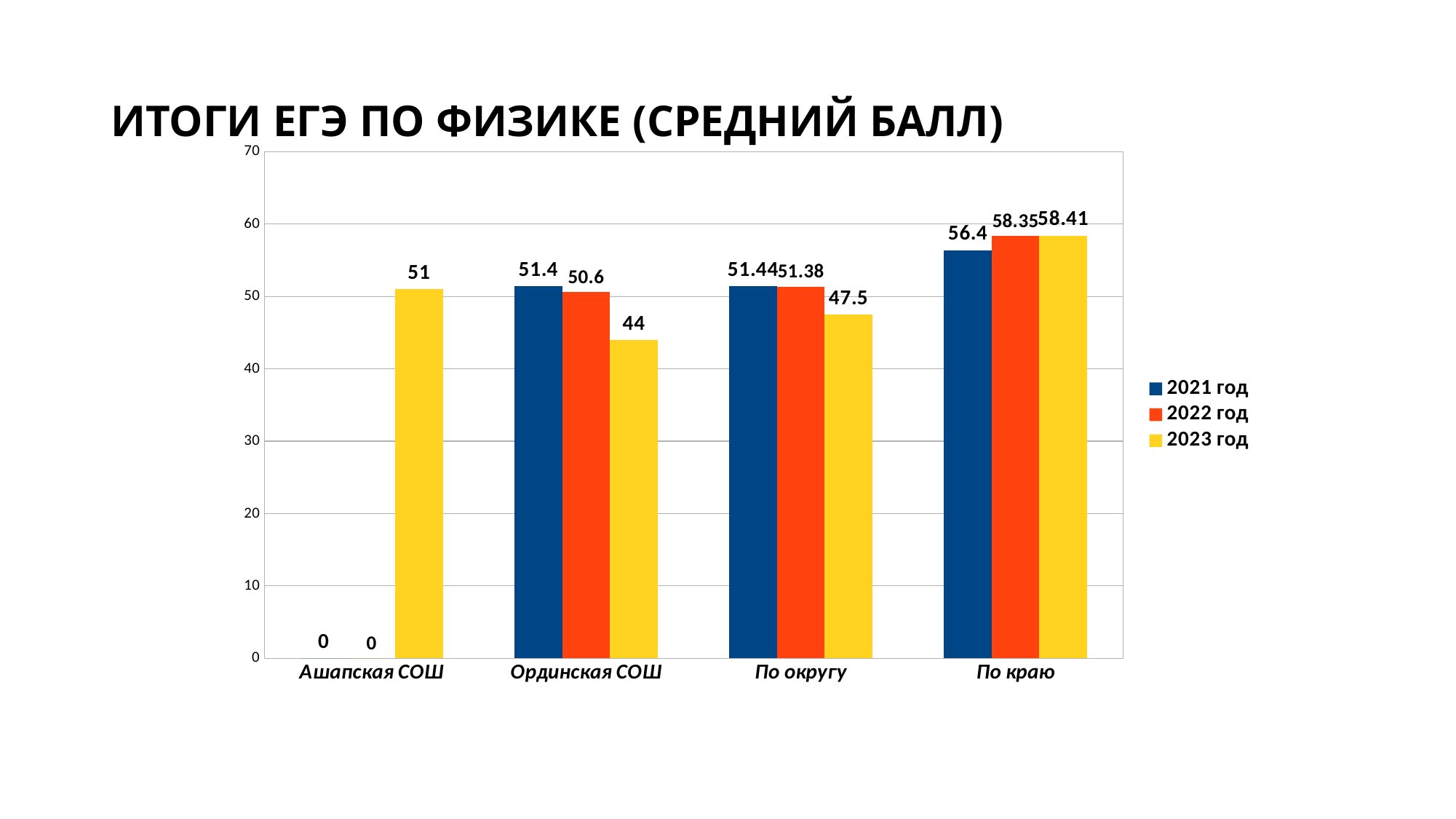
What is the value for По округу in the 2023 год series? 47.5 What is the difference between the 2021 год and 2023 год values for Ординская СОШ? 7.4 What is the title of the chart? ИТОГИ ЕГЭ ПО ФИЗИКЕ (СРЕДНИЙ БАЛЛ) Which category has the highest value in the 2023 год series? По краю What is the value for Ординская СОШ in the 2021 год series? 51.4 What type of chart is shown on the slide? bar chart How many series does the legend list? 3 Which is larger for По округу: the 2021 год value or the 2023 год value? 2021 год How many categories are shown on the x axis? 4 Which category has the lowest value in the 2021 год series? Ашапская СОШ What is the value for По краю in the 2022 год series? 58.35 What is the value for Ашапская СОШ in the 2023 год series? 51